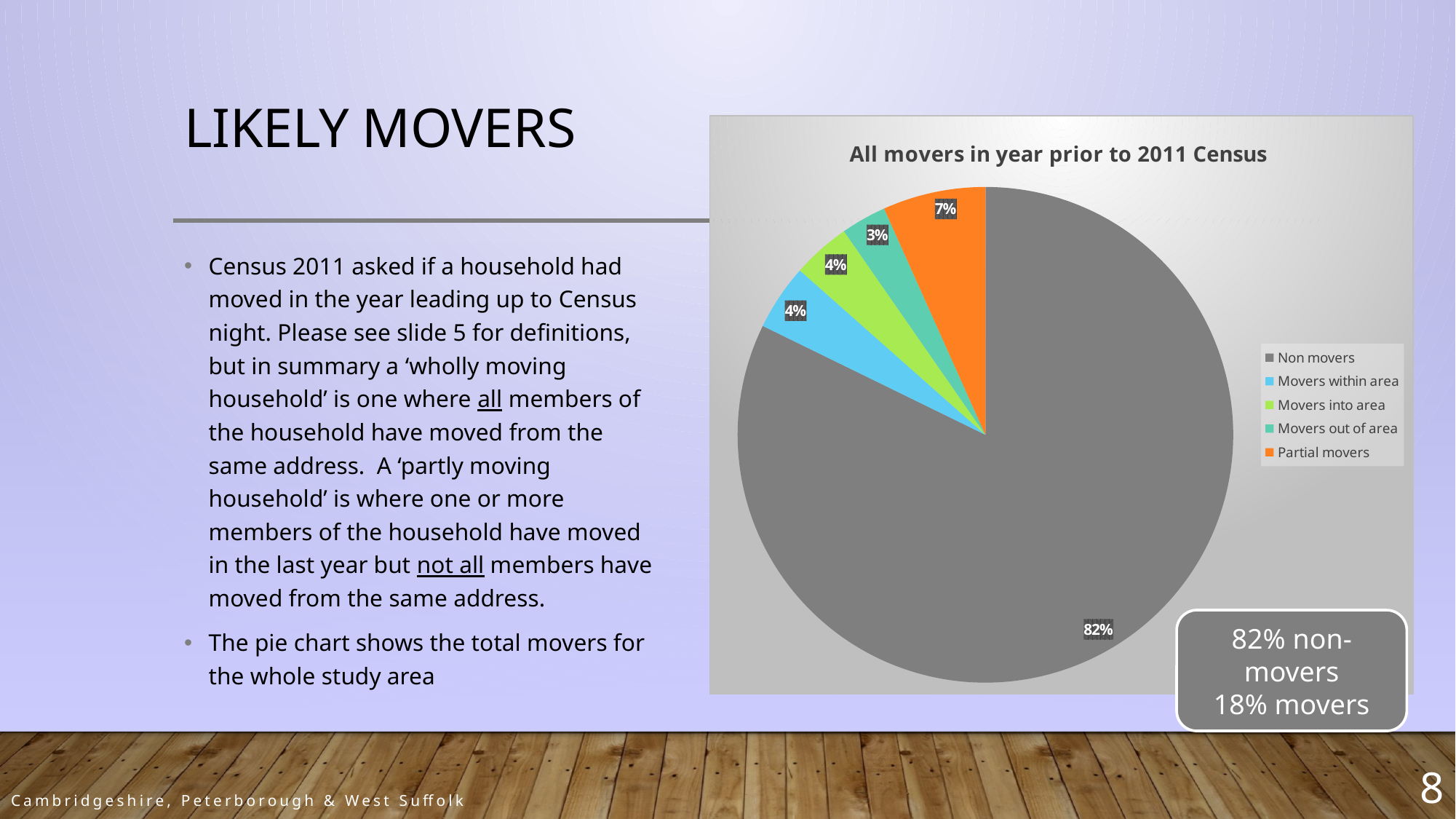
What share of the pie is Movers within area? 4% Which category has the largest slice of the pie? Non movers What is the difference in percentage points between Non movers and Partial movers? 75 Which is larger, Partial movers or Movers into area? Partial movers How many categories does the pie chart show? 5 What colour is the Partial movers slice? orange Which category has the smallest slice of the pie? Movers out of area What is the title of the chart? All movers in year prior to 2011 Census What share of the pie is Partial movers? 7% What kind of chart is shown on the slide? pie chart What share of the pie is Non movers? 82%